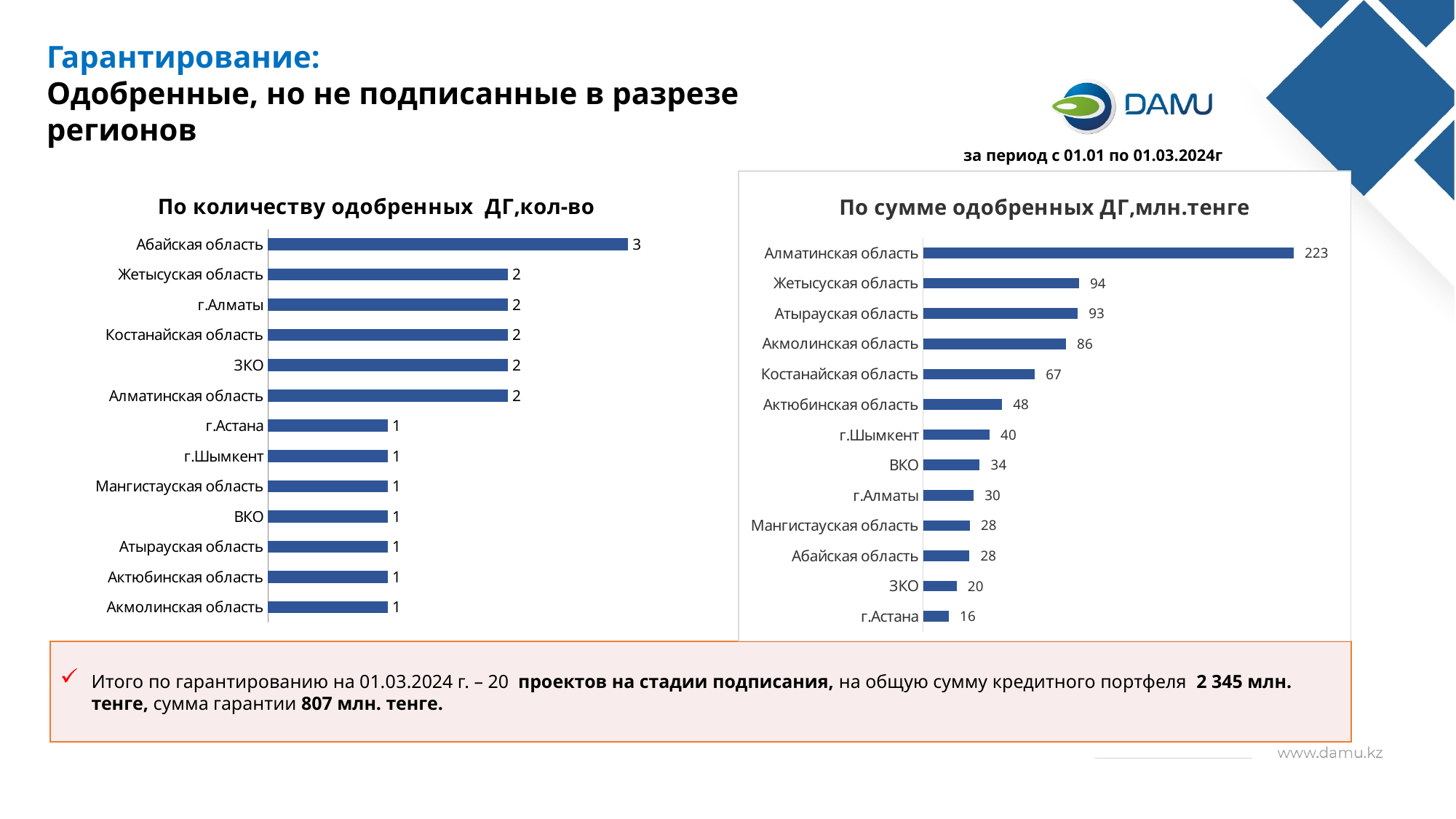
What is the title of the chart on the left side of the slide? По количеству одобренных ДГ,кол-во How many categories are shown in the chart 'По сумме одобренных ДГ,млн.тенге'? 13 In the chart 'По количеству одобренных ДГ,кол-во', what is the value for Абайская область? 3 In the chart 'По сумме одобренных ДГ,млн.тенге', what is the value for Алматинская область? 223 In the chart 'По количеству одобренных ДГ,кол-во', which region has the highest value? Абайская область In the chart 'По сумме одобренных ДГ,млн.тенге', which is larger: Актюбинская область or г.Шымкент? Актюбинская область In the chart 'По сумме одобренных ДГ,млн.тенге', which region has the lowest value? г.Астана How many categories are shown in the chart 'По количеству одобренных ДГ,кол-во'? 13 What type of chart is 'По сумме одобренных ДГ,млн.тенге'? Bar chart In the chart 'По сумме одобренных ДГ,млн.тенге', what is the value for ЗКО? 20 In the chart 'По сумме одобренных ДГ,млн.тенге', what is the difference between Алматинская область and Жетысуская область? 129 In the chart 'По сумме одобренных ДГ,млн.тенге', what is the value for Костанайская область? 67